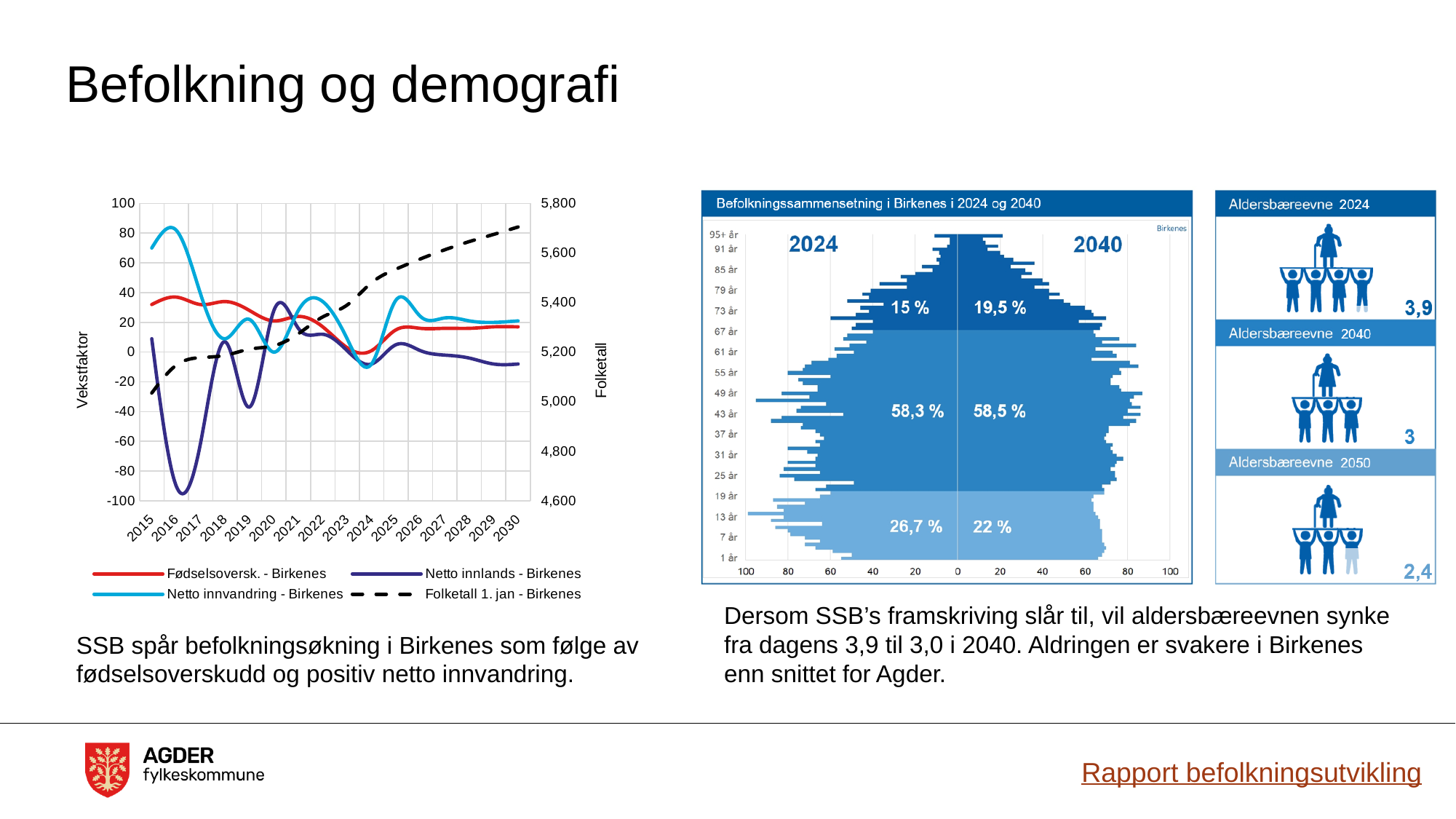
How many series does the legend of the left-hand line chart list? 4 In the left-hand line chart, is the 'Folketall 1. jan - Birkenes' value in 2030 greater or less than 5,600? greater In the left-hand line chart, is the value of 'Netto innlands - Birkenes' in 2016 greater or less than -80? less In the chart 'Befolkningssammensetning i Birkenes i 2024 og 2040', by how many percentage points does the share of the oldest age group increase from 2024 to 2040? 4,5 In the chart 'Befolkningssammensetning i Birkenes i 2024 og 2040', is the share of the oldest age group larger in 2024 or in 2040? 2040 In the chart 'Befolkningssammensetning i Birkenes i 2024 og 2040', what share of the population is in the oldest age group (67+) in 2024? 15 % What kind of chart is the chart on the left of the slide (Vekstfaktor / Folketall)? line chart In the left-hand line chart, is the 'Folketall 1. jan - Birkenes' value in 2015 greater or less than 5,200? less In the left-hand line chart, does the dashed 'Folketall 1. jan - Birkenes' line rise or fall from 2015 to 2030? rise In the 'Aldersbæreevne' panels on the right, which year has the lowest value? 2050 In the chart 'Befolkningssammensetning i Birkenes i 2024 og 2040', what share of the population is in the youngest age group in 2040? 22 % In the chart 'Befolkningssammensetning i Birkenes i 2024 og 2040', what is the share of the middle age group in 2024? 58,3 %